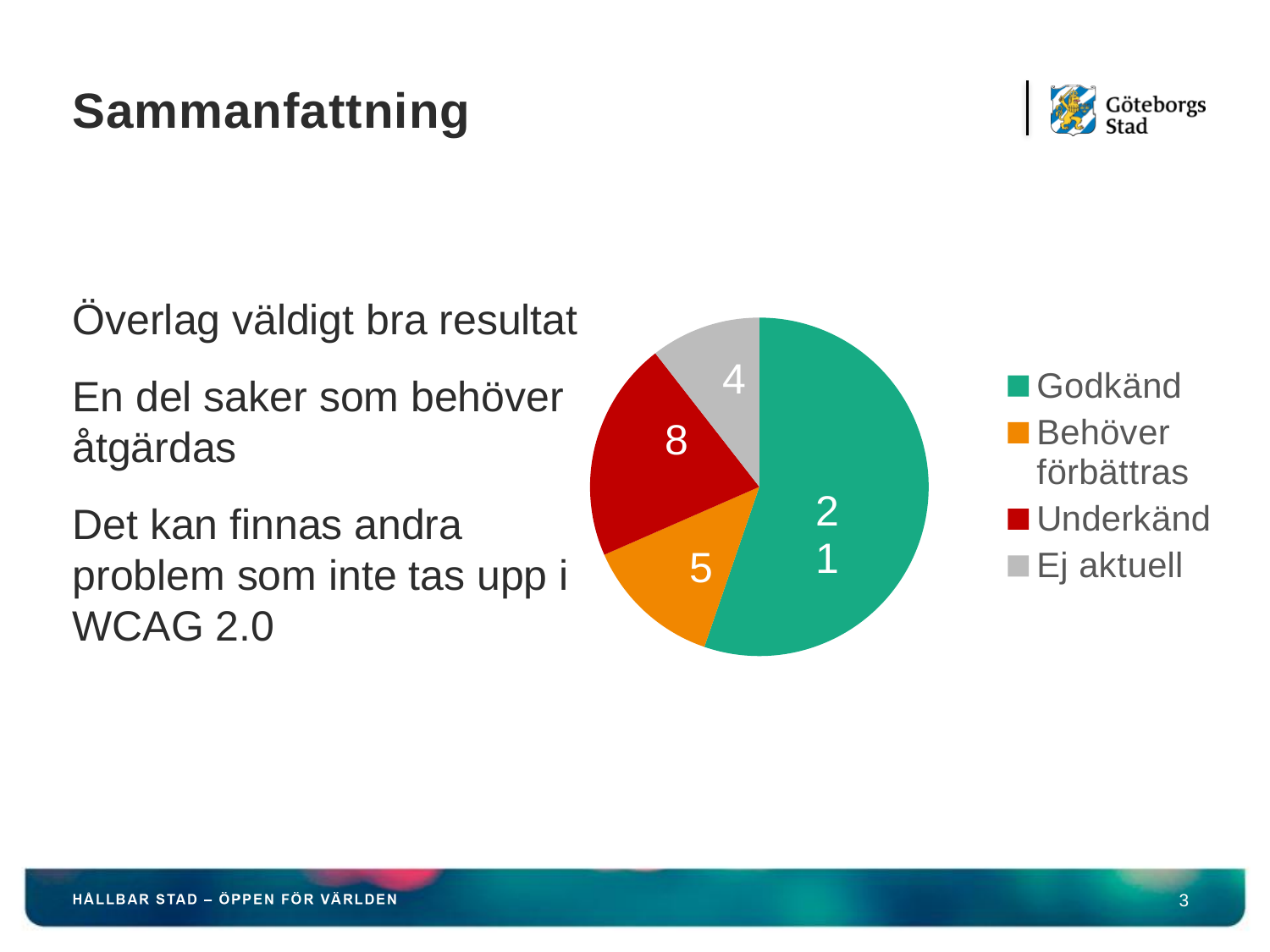
What is the difference between the values for Godkänd and Underkänd? 13 Which is larger, Underkänd or Behöver förbättras? Underkänd Which category has the largest slice in the pie chart? Godkänd What colour is the Underkänd slice in the pie chart? red How many categories does the pie chart have? 4 What kind of chart is shown on the slide? pie chart What is the total of all slices in the pie chart? 38 What is the value for Underkänd in the pie chart? 8 What is the value for Behöver förbättras in the pie chart? 5 What is the value for Godkänd in the pie chart? 21 What is the value for Ej aktuell in the pie chart? 4 Which category has the smallest slice in the pie chart? Ej aktuell